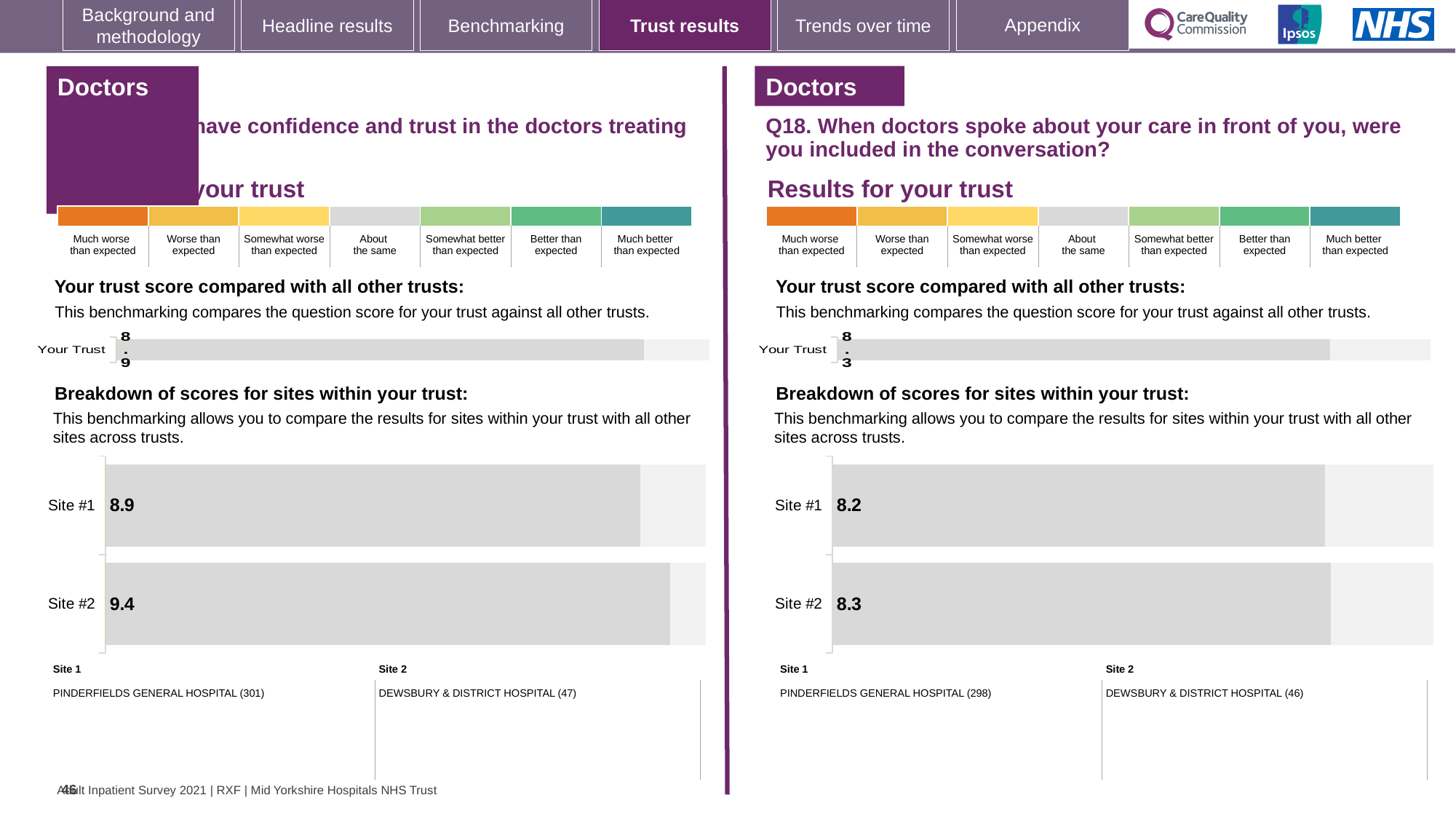
On the Q18 site breakdown chart, what is the difference between the Site #2 and Site #1 scores? 0.1 On the left-hand 'Breakdown of scores for sites within your trust' chart, what is the score for Site #1? 8.9 How many sites are shown on the Q18 'Breakdown of scores for sites within your trust' chart? 2 Is the Site #1 score on the left-hand site breakdown chart larger or smaller than the Site #1 score on the Q18 site breakdown chart? Larger On the left-hand site breakdown chart, which site has the higher score? Site #2 On the left-hand site breakdown chart, what is the difference between the Site #2 and Site #1 scores? 0.5 What type of chart is used for the Q18 'Breakdown of scores for sites within your trust'? Bar chart On the Q18 'Breakdown of scores for sites within your trust' chart, what is the score for Site #2? 8.3 On the left-hand 'Breakdown of scores for sites within your trust' chart, what is the score for Site #2? 9.4 On the Q18 'Breakdown of scores for sites within your trust' chart, what is the score for Site #1? 8.2 On the Q18 'Your trust score compared with all other trusts' chart, what is the score shown for Your Trust? 8.3 On the left-hand 'Your trust score compared with all other trusts' chart, what is the score shown for Your Trust? 8.9